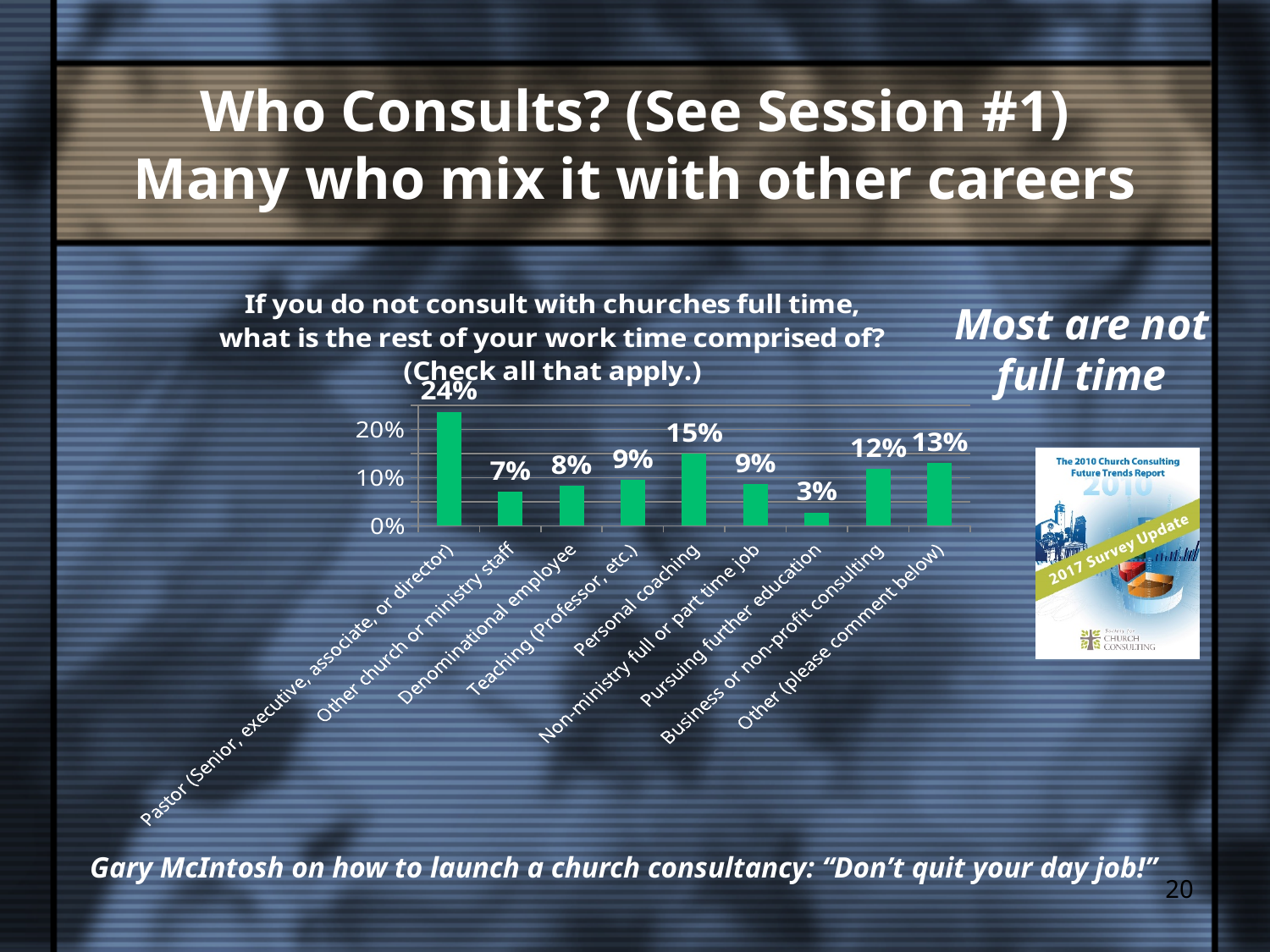
Which category has the lowest percentage? Pursuing further education What is the title of the chart? If you do not consult with churches full time, what is the rest of your work time comprised of? (Check all that apply.) Which is larger, the value for Other (please comment below) or the value for Business or non-profit consulting? Other (please comment below) What percentage is shown for Pastor (Senior, executive, associate, or director)? 24% What kind of chart is shown on the slide? Bar chart What percentage is shown for Business or non-profit consulting? 12% Which category has the highest percentage? Pastor (Senior, executive, associate, or director) How many categories are shown in the chart? 9 What percentage is shown for Personal coaching? 15% What is the difference between the percentages for Pastor (Senior, executive, associate, or director) and Personal coaching? 9% Is the value for Personal coaching greater or less than 10%? greater What percentage is shown for Pursuing further education? 3%